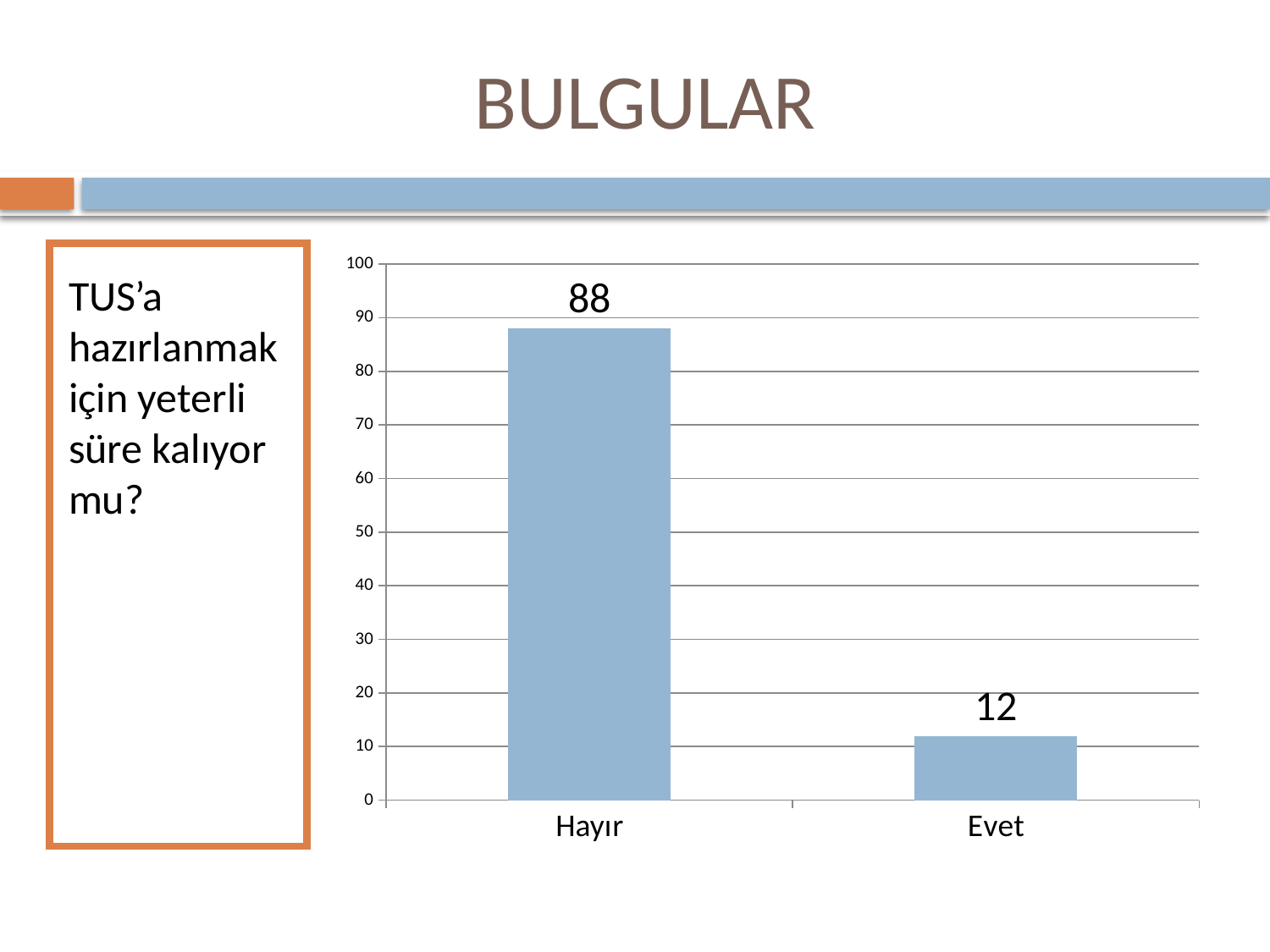
What kind of chart is shown on the slide? bar chart Which category has the lowest value? Evet Which is larger, the value for Hayır or the value for Evet? Hayır What is the maximum value shown on the y axis? 100 How many categories are shown on the x axis? 2 What is the difference between the values for Hayır and Evet? 76 Is the value for Evet greater or less than 20? less What is the value for Evet? 12 Which category has the highest value? Hayır What is the value for Hayır? 88 Is the value for Hayır greater or less than 80? greater What is the total of the two bar values? 100